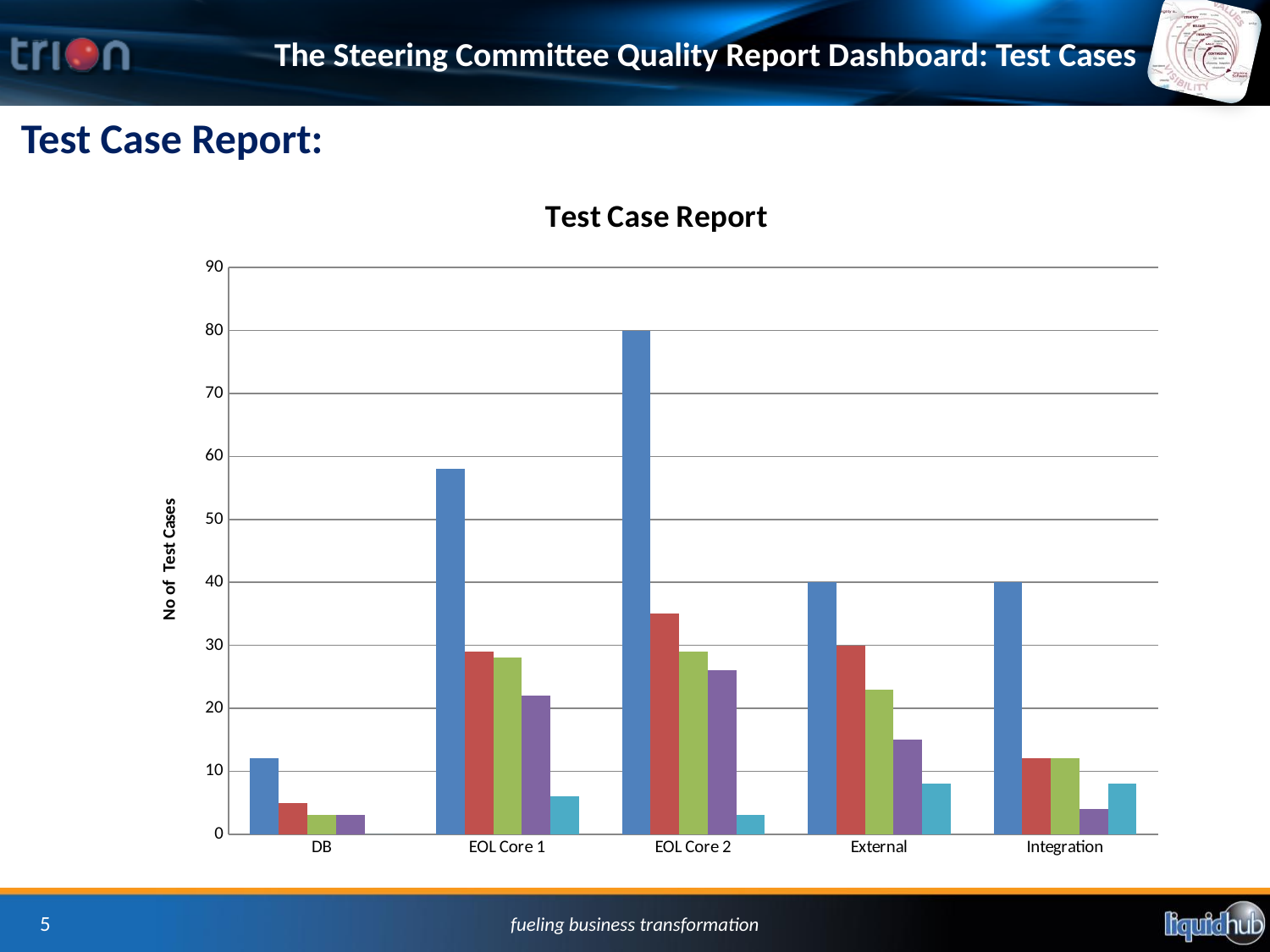
What is the value of the blue bar for EOL Core 2? 80 What is the difference between the blue bars for EOL Core 2 and External? 40 What type of chart is shown on the slide? bar chart Is the blue bar for DB greater or less than 20? less How many categories are shown on the x axis of the chart? 5 What is the label on the vertical axis of the chart? No of Test Cases What is the value of the blue bar for Integration? 40 What is the title of the chart? Test Case Report Which category has the lowest blue bar? DB Is the blue bar for EOL Core 1 greater or less than 50? greater What is the value of the blue bar for External? 40 Which category has the tallest bar in the chart? EOL Core 2